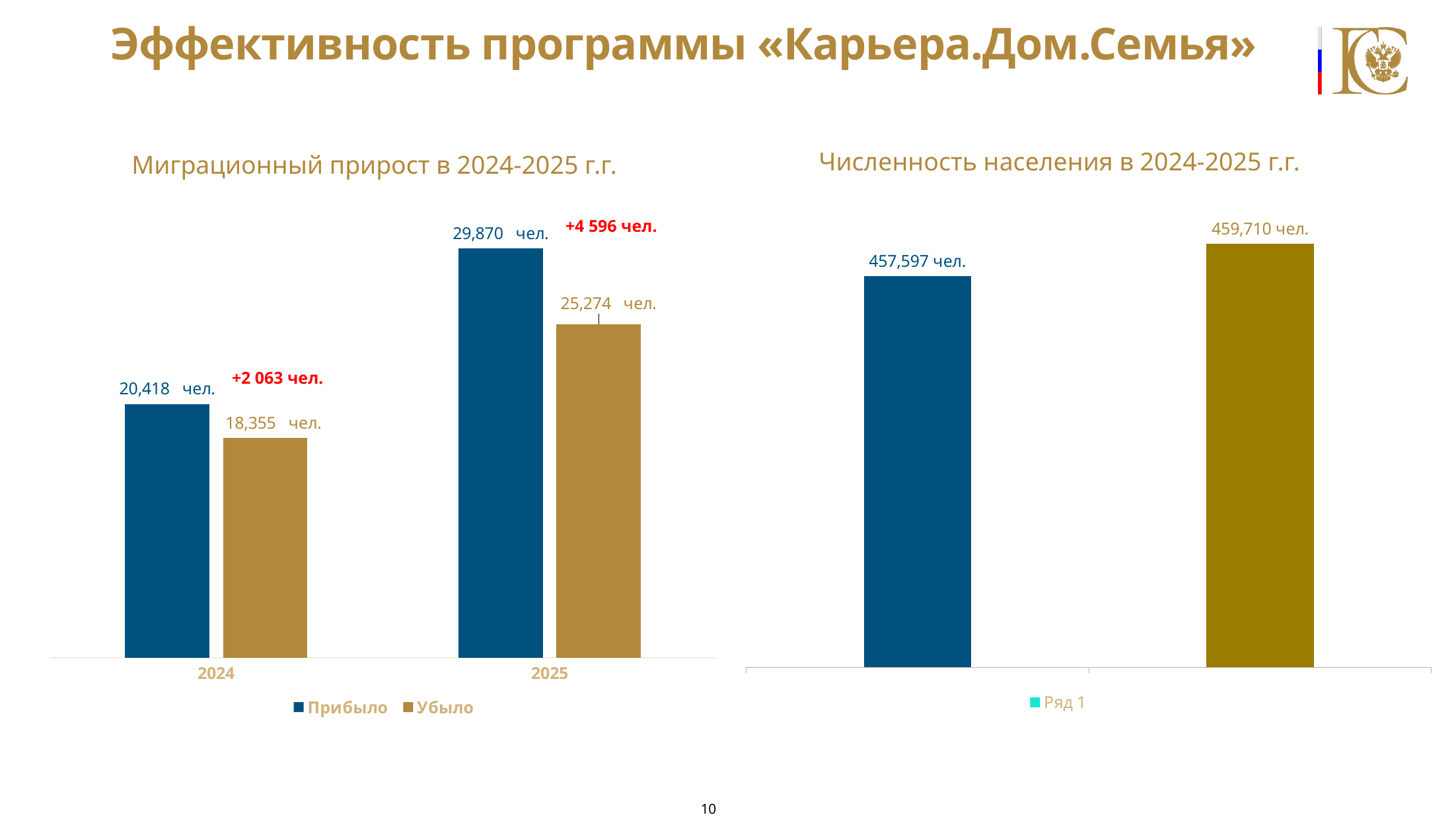
What kind of chart is the chart titled «Численность населения в 2024-2025 г.г.»? bar chart In the chart titled «Миграционный прирост в 2024-2025 г.г.», what is the value for Прибыло in 2024? 20,418 чел. In the chart titled «Миграционный прирост в 2024-2025 г.г.», how many series does the legend list? 2 In the chart titled «Численность населения в 2024-2025 г.г.», what is the difference between the right bar and the left bar? 2,113 чел. In the chart titled «Миграционный прирост в 2024-2025 г.г.», does the value for Прибыло rise or fall from 2024 to 2025? rise In the chart titled «Численность населения в 2024-2025 г.г.», what is the value of the left (blue) bar? 457,597 чел. In the chart titled «Миграционный прирост в 2024-2025 г.г.», what is the value for Убыло in 2024? 18,355 чел. In the chart titled «Миграционный прирост в 2024-2025 г.г.», which bar is the highest? Прибыло in 2025 In the chart titled «Миграционный прирост в 2024-2025 г.г.», which bar is the lowest? Убыло in 2024 In the chart titled «Миграционный прирост в 2024-2025 г.г.», what is the difference between Прибыло and Убыло in 2025? 4,596 чел. In the chart titled «Миграционный прирост в 2024-2025 г.г.», which is larger in 2024: Прибыло or Убыло? Прибыло In the chart titled «Миграционный прирост в 2024-2025 г.г.», what is the value for Убыло in 2025? 25,274 чел.